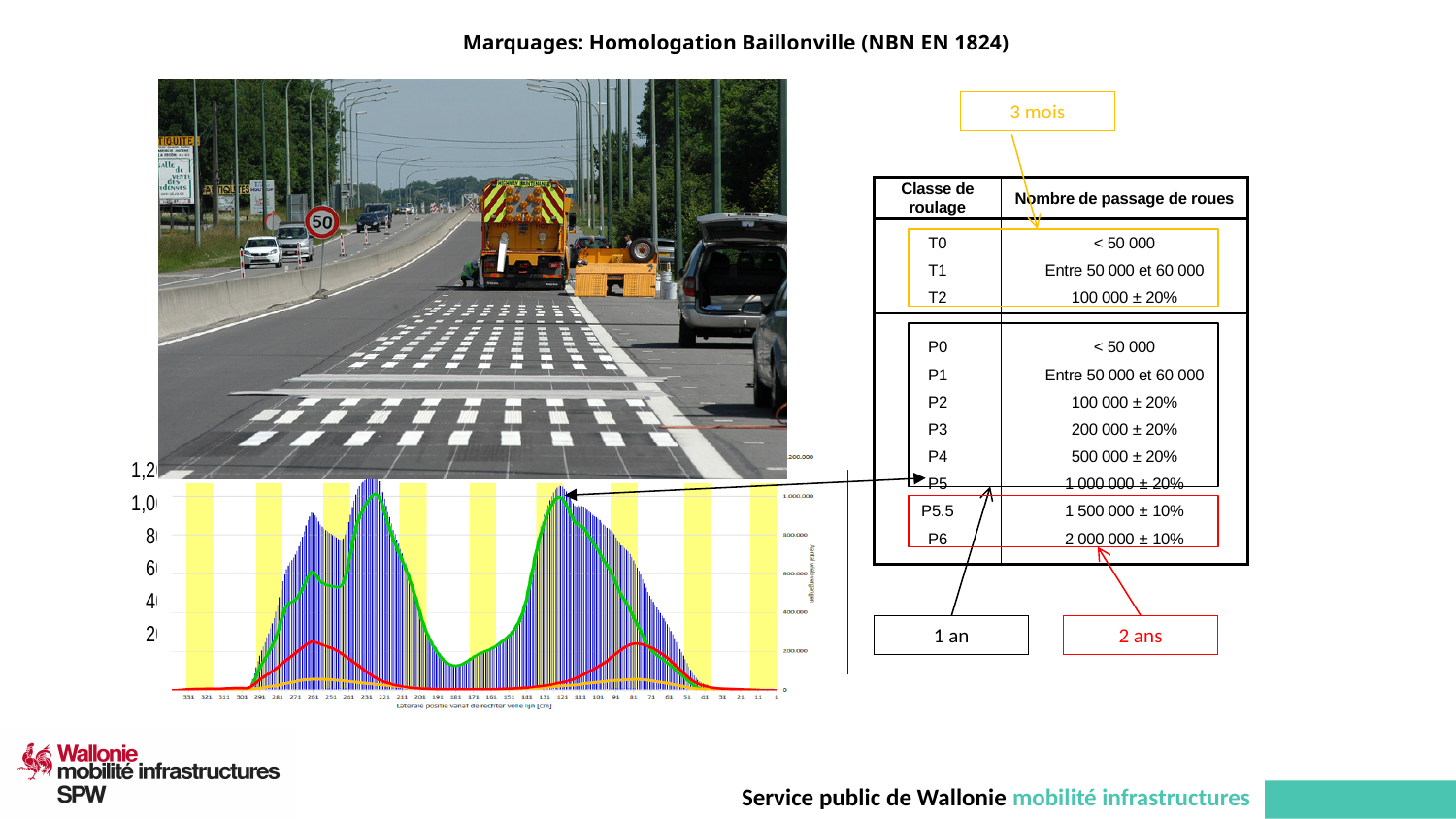
Does the green line rise or fall moving from the left edge of the x axis (331) toward its first peak? rise What kind of chart is shown at the bottom left of the slide? bar chart with line overlays Is the tallest blue bar greater or less than 800.000 on the right-hand axis? greater How many peaks does the green line show across the x axis? 2 Is the green line at its central trough (around x = 181) greater or less than 400.000 on the right-hand axis? less What is the highest tick value shown on the right-hand axis of the chart? 1.200.000 Is the peak of the red line greater or less than 400.000 on the right-hand axis? less Which line reaches higher values on the chart, the green line or the red line? green What is the x-axis title of the chart at the bottom left? Laterale positie vanaf de rechter volle lijn [cm]